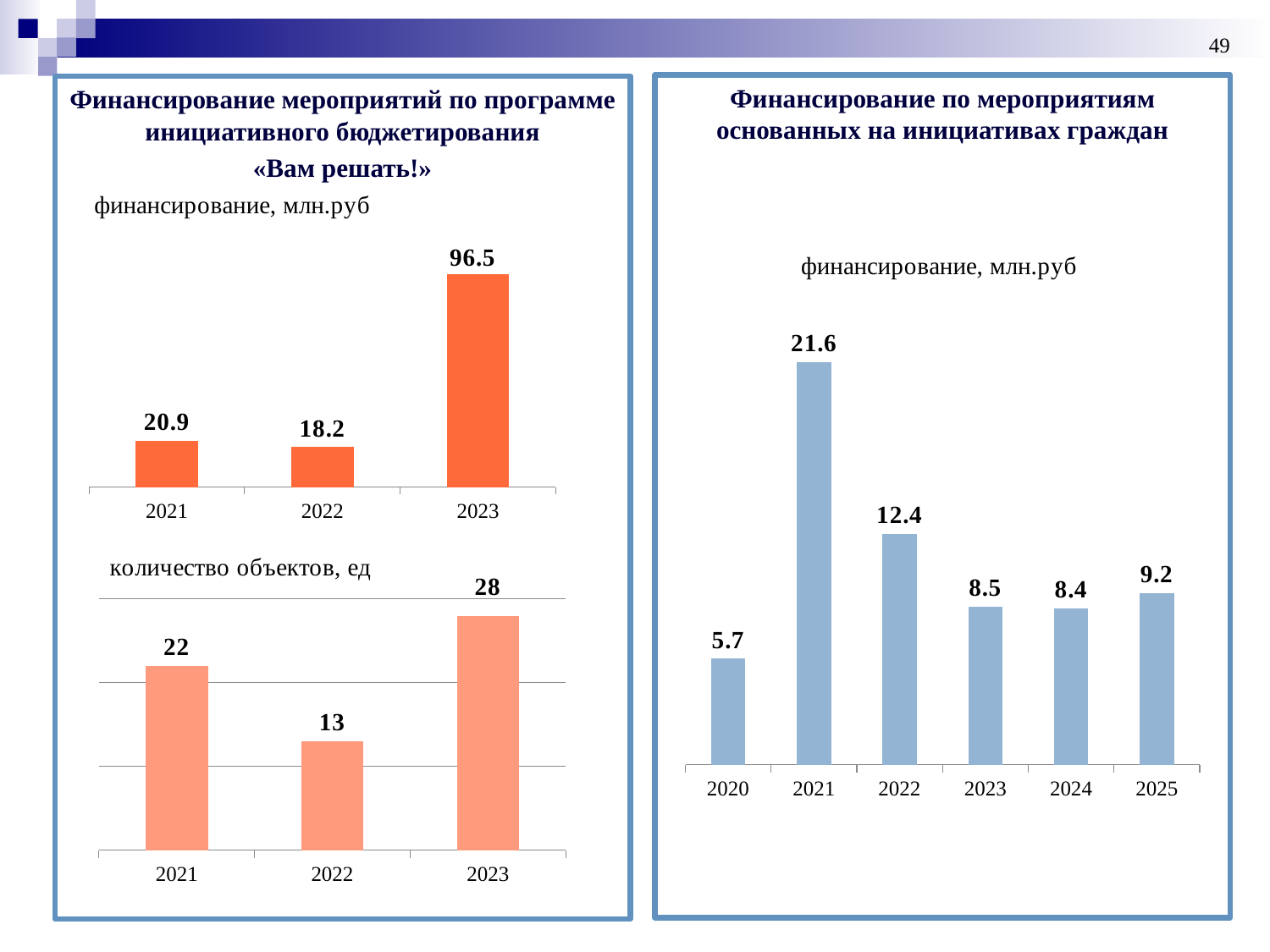
What type of chart is the right chart (Финансирование по мероприятиям основанных на инициативах граждан)? Bar chart In the bottom-left chart (количество объектов, ед), what is the value for 2022? 13 In the bottom-left chart (количество объектов, ед), which year has the highest value? 2023 In the right chart (Финансирование по мероприятиям основанных на инициативах граждан), what is the difference between the 2021 and 2022 values? 9.2 In the bottom-left chart (количество объектов, ед), how many years are shown on the x axis? 3 In the right chart (Финансирование по мероприятиям основанных на инициативах граждан), which is larger, the value for 2022 or the value for 2025? 2022 In the right chart (Финансирование по мероприятиям основанных на инициативах граждан), which year has the highest value? 2021 In the top-left chart (финансирование, млн.руб under «Вам решать!»), what is the difference between the 2023 and 2021 values? 75.6 In the right chart (Финансирование по мероприятиям основанных на инициативах граждан), what is the value for 2020? 5.7 In the right chart (Финансирование по мероприятиям основанных на инициативах граждан), how many years are shown on the x axis? 6 In the top-left chart (финансирование, млн.руб under «Вам решать!»), what is the value for 2023? 96.5 In the top-left chart (финансирование, млн.руб under «Вам решать!»), which year has the lowest value? 2022